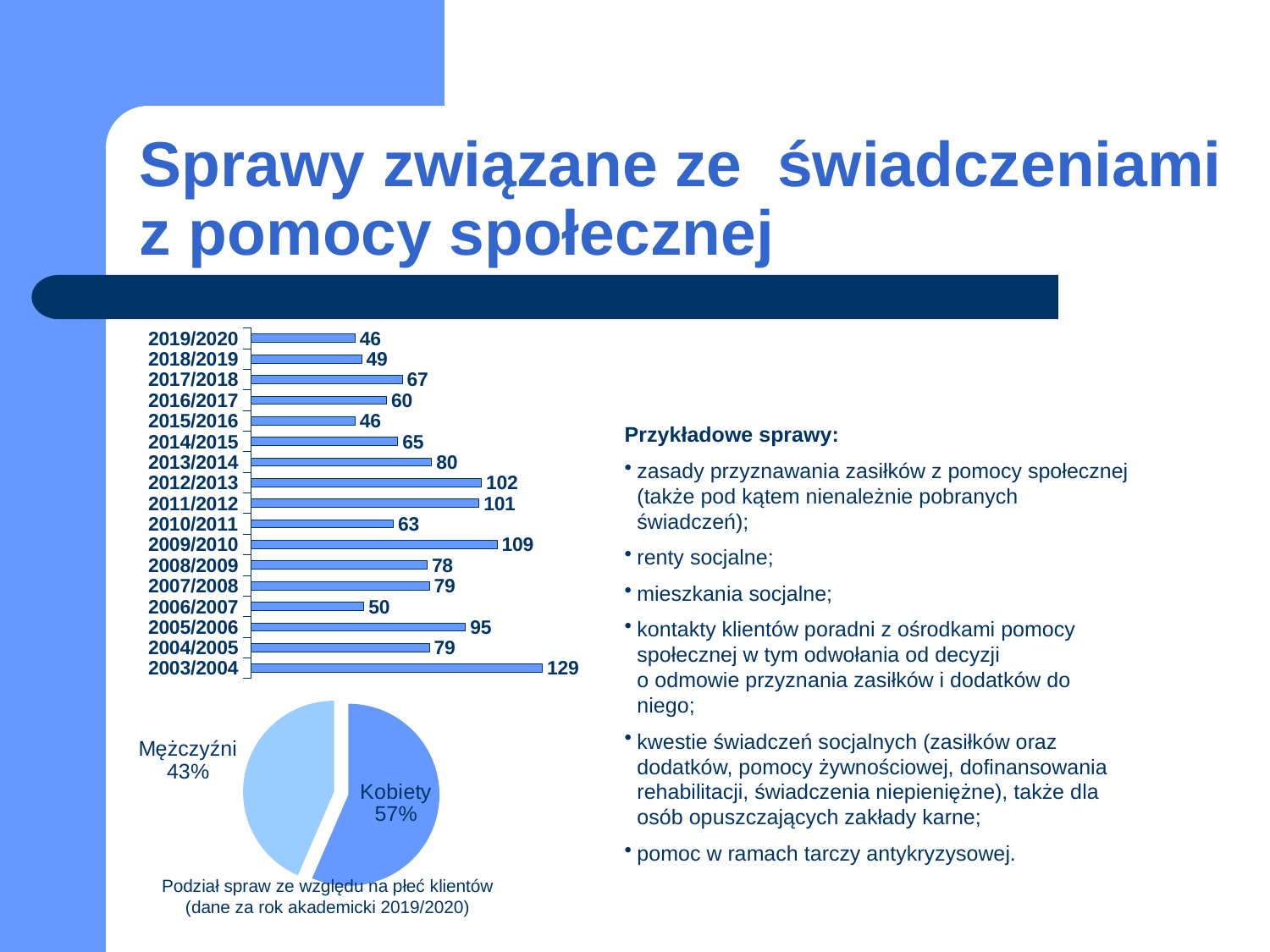
In the pie chart, what share is labelled for Kobiety? 57% In the bar chart, what is the value for 2019/2020? 46 In the bar chart, which is larger, the value for 2005/2006 or the value for 2013/2014? 2005/2006 In the pie chart, which slice is larger, Kobiety or Mężczyźni? Kobiety In the bar chart, which academic year has the highest value? 2003/2004 In the bar chart, what is the difference between the values for 2009/2010 and 2010/2011? 46 In the bar chart, what is the value for 2003/2004? 129 In the pie chart, what share is labelled for Mężczyźni? 43% How many academic years are shown in the bar chart? 17 What kind of chart is the chart at the top left of the slide? Bar chart In the bar chart, what is the value for 2012/2013? 102 What is the caption below the pie chart? Podział spraw ze względu na płeć klientów (dane za rok akademicki 2019/2020)